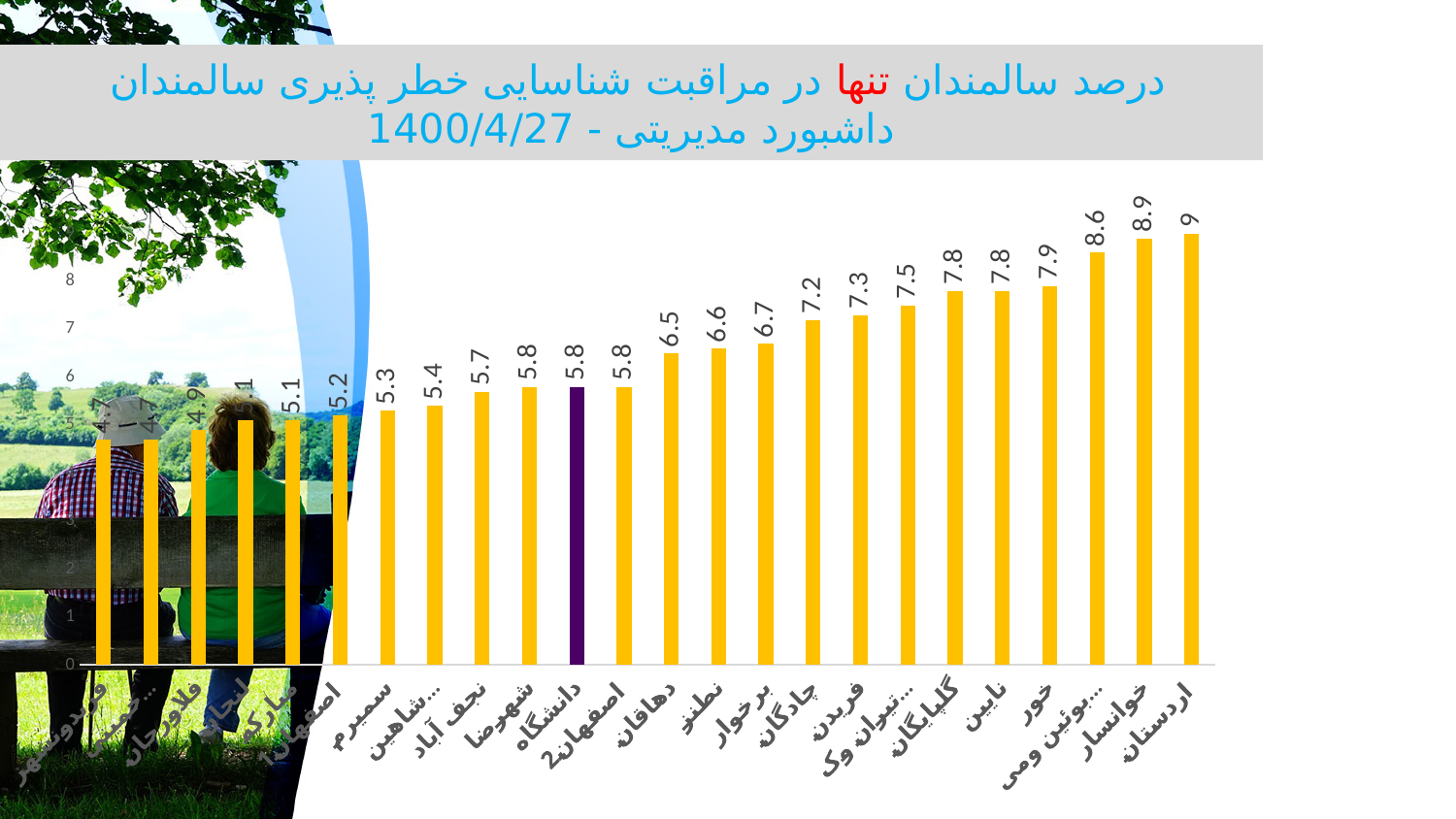
What kind of chart is shown on the slide? bar chart What is the value for دهاقان? 6.5 Which is larger, the value for خور or the value for فریدن? خور Is the value for برخوار greater or less than 6? greater What is the difference between the values for اردستان and دهاقان? 2.5 What is the value for خوانسار? 8.9 What is the value for نجف آباد? 5.7 What is the value for دانشگاه? 5.8 Do the values rise or fall moving from left to right along the x axis? rise Which category's bar is coloured purple instead of yellow? دانشگاه What is the value for اردستان? 9 Which category has the highest value? اردستان